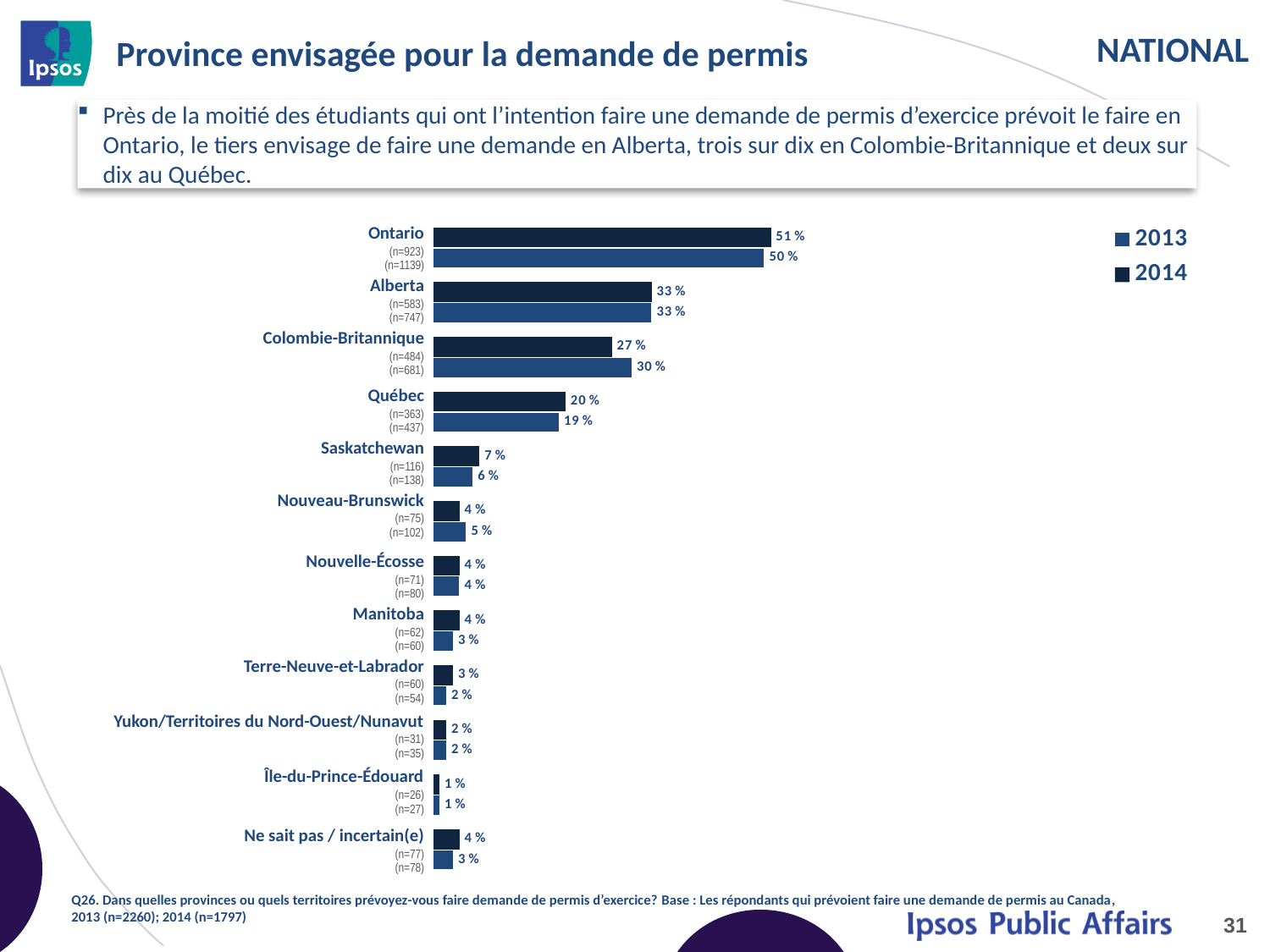
What is the 2014 value for Québec? 19 % What is the difference between the 2013 and 2014 values for Colombie-Britannique? 3 % What are the two series listed in the legend? 2013 and 2014 What is the 2014 value for Colombie-Britannique? 30 % What kind of chart is shown on the slide? Bar chart How many series does the legend list? 2 Which province has the highest 2014 value? Ontario What is the 2013 value for Saskatchewan? 7 % What is the 2013 value for Ontario? 51 % Which is larger for Nouveau-Brunswick, the 2013 value or the 2014 value? 2014 How many categories are shown on the chart? 12 Which province has the lowest 2013 value? Île-du-Prince-Édouard